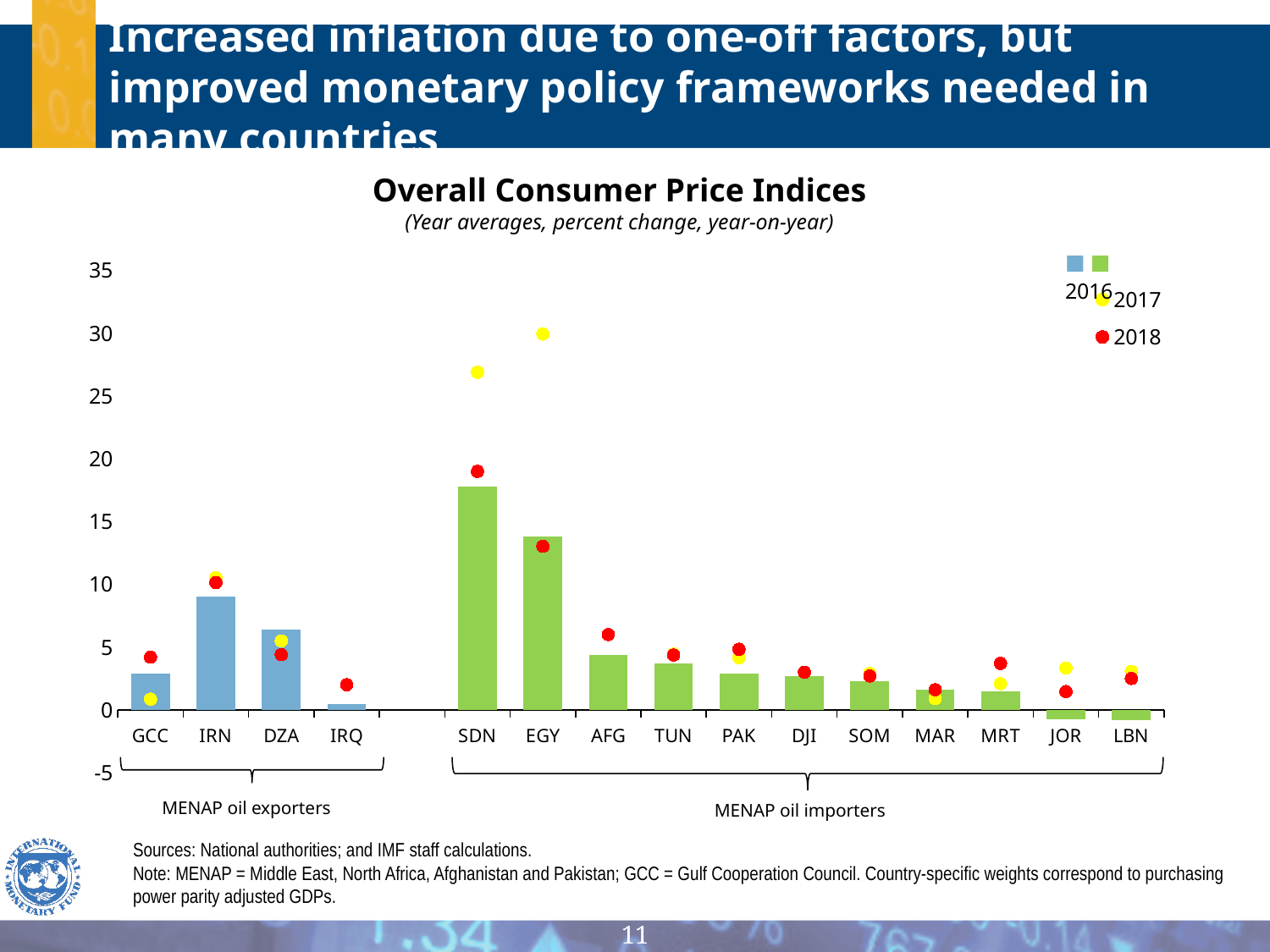
Is the 2017 value for EGY greater or less than 25? greater Is the 2016 value for SDN greater or less than 15? greater How many series does the chart's legend list? 3 Which country has the highest 2017 value (yellow dot) in the chart? EGY Is the 2016 value for EGY greater or less than 10? greater How many countries or groups are shown along the x axis of the chart? 15 Which has the larger 2016 bar, IRN or DZA? IRN What is the title of the chart? Overall Consumer Price Indices What kind of chart is shown on the slide? Combination chart with bars (2016) and dot markers (2017, 2018) How many countries are grouped under the 'MENAP oil exporters' bracket in the chart? 4 Which country has the highest 2016 bar in the chart? SDN